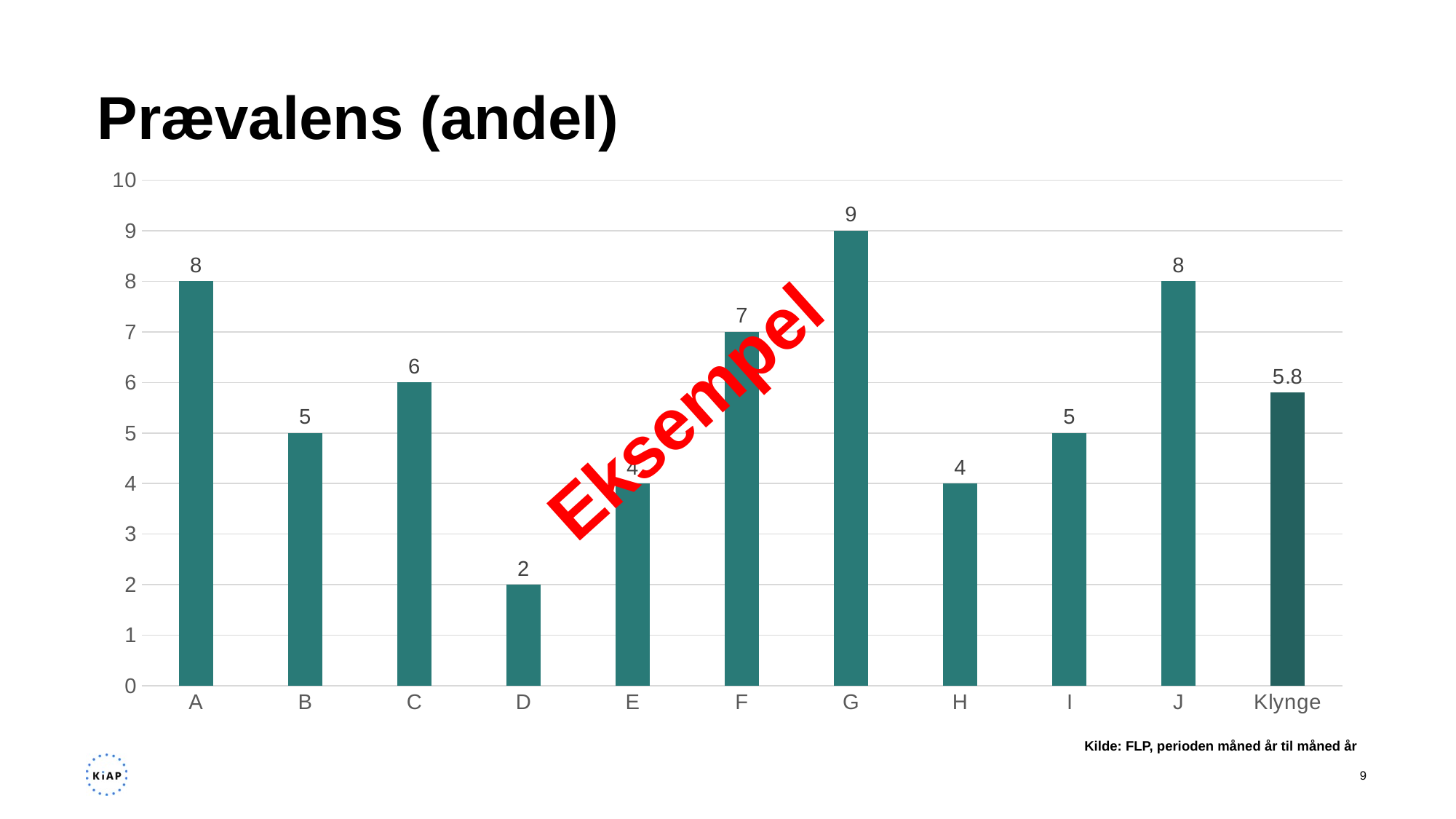
What is the value for Klynge? 5.8 What is the difference between the values for A and B? 3 Which is larger, the value for C or the value for H? C What is the difference between the values for G and D? 7 Which category has the lowest value? D Which categories share the value 8? A and J Which category has the highest value? G How many categories are shown on the x axis? 11 What is the title of the slide? Prævalens (andel) What kind of chart is shown on the slide? bar chart What is the value for category D? 2 What is the value for category G? 9